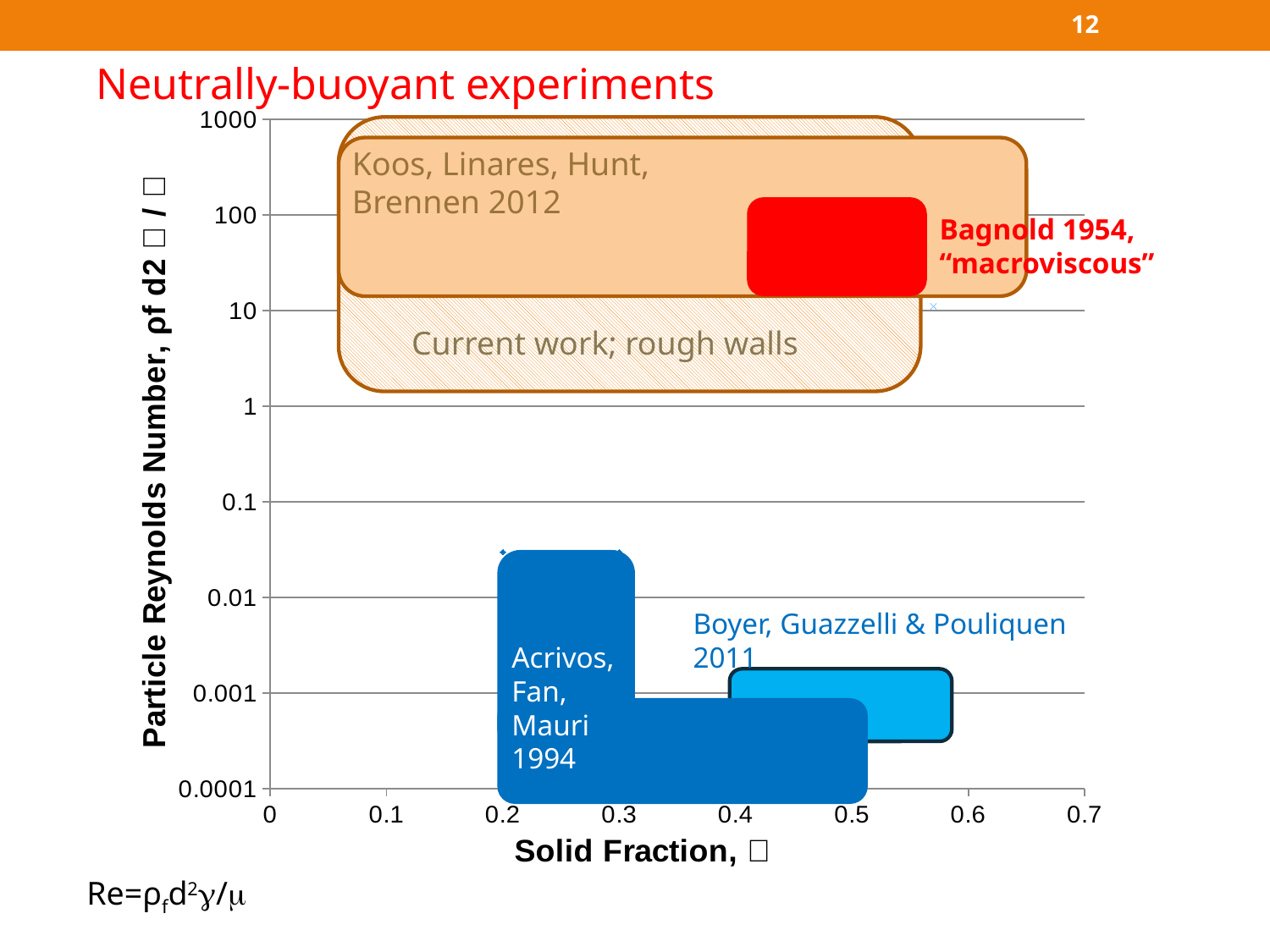
What is the label of the x axis of the chart? Solid Fraction Which labelled region reaches the lowest Particle Reynolds Numbers on the chart? Acrivos, Fan, Mauri 1994 What is the highest tick value shown on the x axis of the chart? 0.7 Which region lies at higher Particle Reynolds Numbers: Bagnold 1954 "macroviscous" or Boyer, Guazzelli & Pouliquen 2011? Bagnold 1954 "macroviscous" Is the Particle Reynolds Number for the Acrivos, Fan, Mauri 1994 region greater or less than 1? less What is the title of the slide containing the chart? Neutrally-buoyant experiments Which region lies at higher Particle Reynolds Numbers: Koos, Linares, Hunt, Brennen 2012 or Acrivos, Fan, Mauri 1994? Koos, Linares, Hunt, Brennen 2012 Is the Particle Reynolds Number for the Bagnold 1954 "macroviscous" region greater or less than 10? greater How many labelled experimental regions are shown on the chart? 5 What is the highest tick value shown on the y axis of the chart? 1000 Which labelled region reaches the highest Particle Reynolds Numbers on the chart? Current work; rough walls Is the Particle Reynolds Number for the Boyer, Guazzelli & Pouliquen 2011 region greater or less than 0.01? less